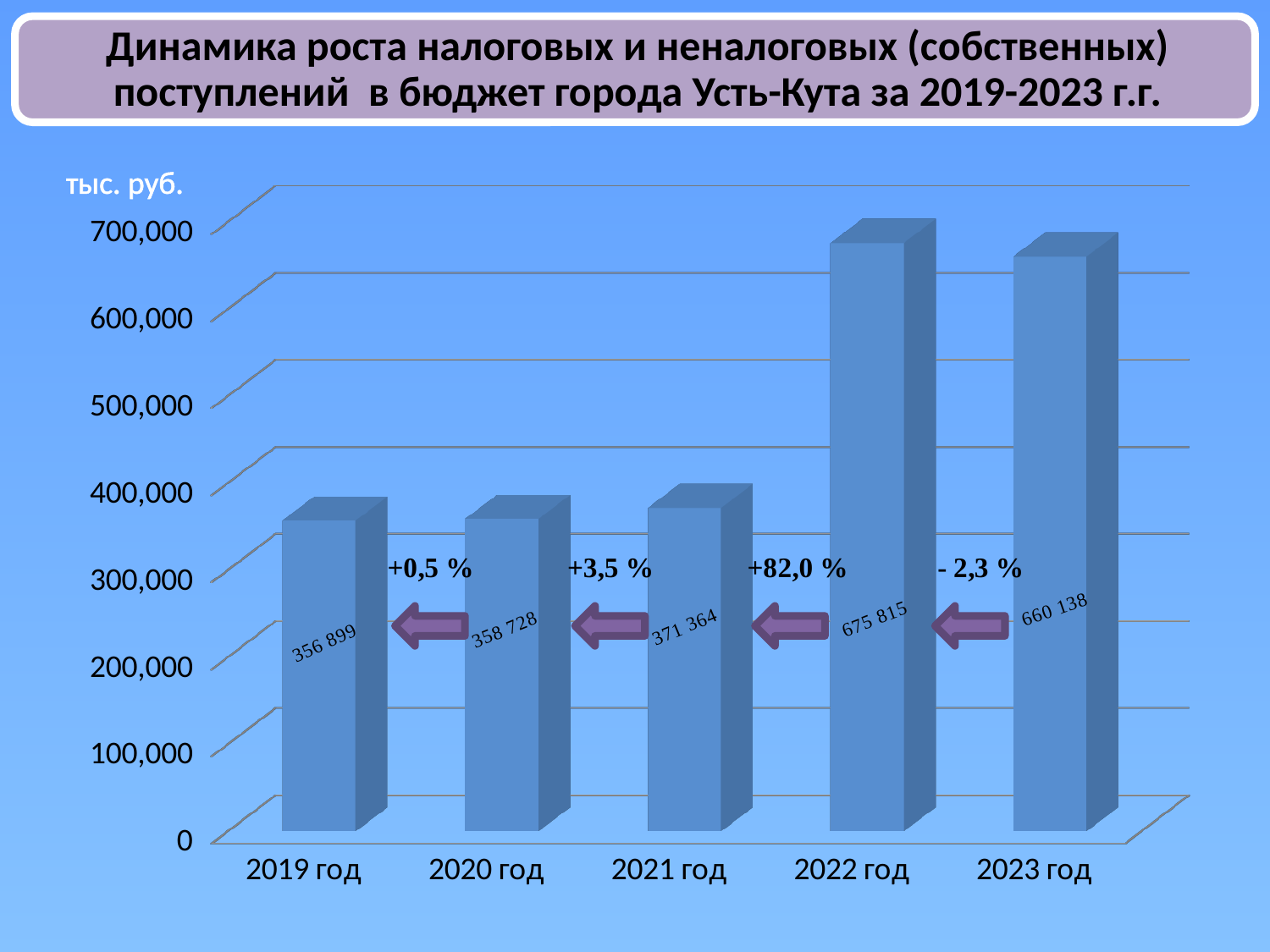
Which year has the highest value? 2022 год Which year has the lowest value? 2019 год What is the difference between the values for 2022 год and 2021 год? 304 451 What percentage change is shown between 2021 год and 2022 год? +82,0 % What is the value for 2023 год? 660 138 What kind of chart is shown on the slide? bar chart Is the value for 2023 год greater or less than 600,000? greater What is the value for 2019 год? 356 899 What is the difference between the values for 2022 год and 2023 год? 15 677 How many years are shown on the x axis? 5 What is the value for 2022 год? 675 815 Which is larger, the value for 2021 год or the value for 2020 год? 2021 год